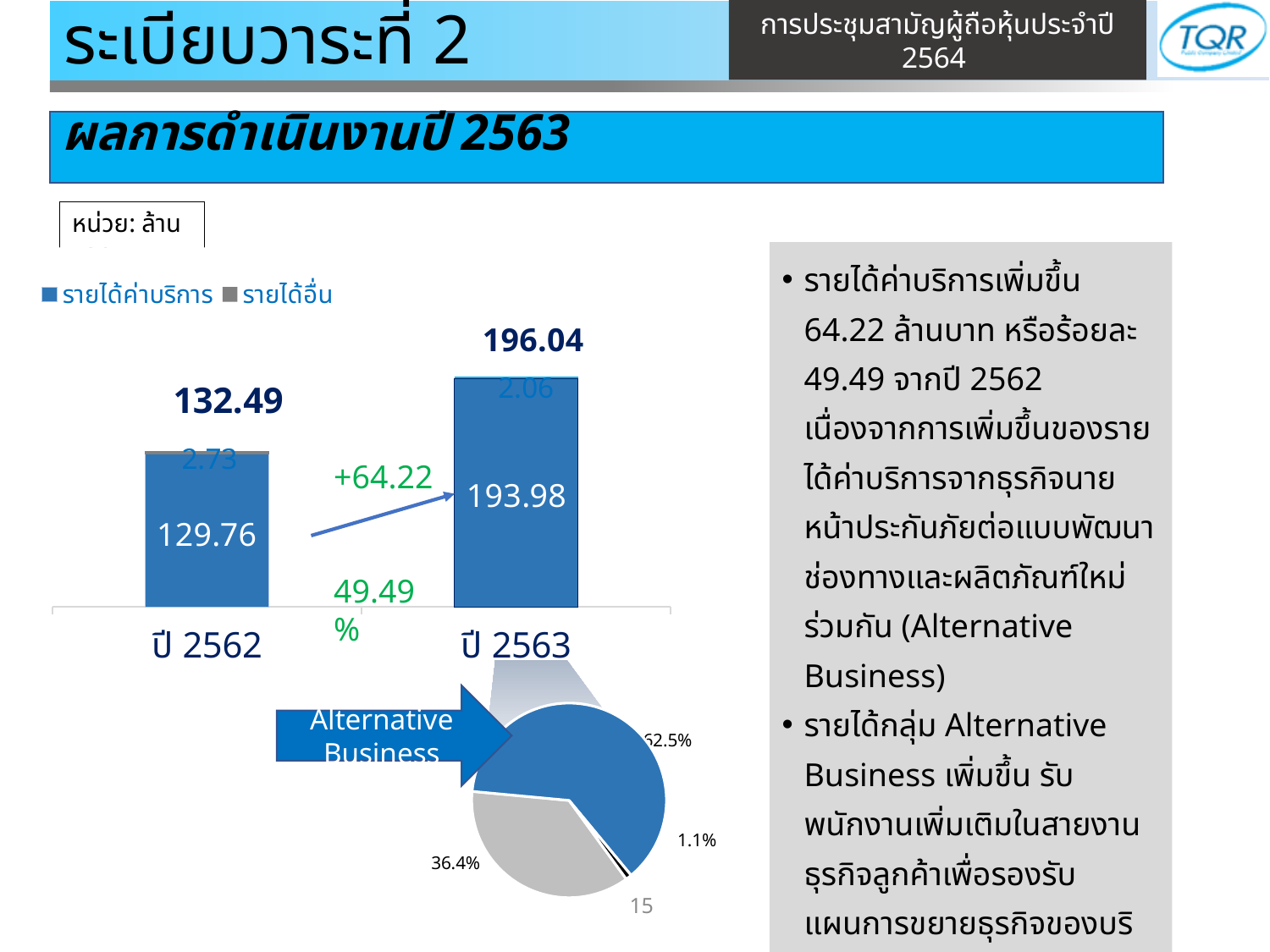
In the pie chart at the bottom, what is the share of the smallest slice? 1.1% What type of chart is the upper chart on the slide? Bar chart In the bar chart, what is the value of รายได้อื่น for ปี 2563? 2.06 In the bar chart, how many series does the legend list? 2 In the bar chart, what is the value of รายได้อื่น for ปี 2562? 2.73 In the pie chart at the bottom, how many slices are there? 3 In the bar chart, what is the difference in รายได้ค่าบริการ between ปี 2563 and ปี 2562? 64.22 In the bar chart, what is the value of รายได้ค่าบริการ for ปี 2563? 193.98 In the bar chart, what is the total of the stacked bar for ปี 2563? 196.04 In the bar chart, what is the total of the stacked bar for ปี 2562? 132.49 In the bar chart, what is the value of รายได้ค่าบริการ for ปี 2562? 129.76 In the bar chart, which year has the higher รายได้ค่าบริการ, ปี 2562 or ปี 2563? ปี 2563